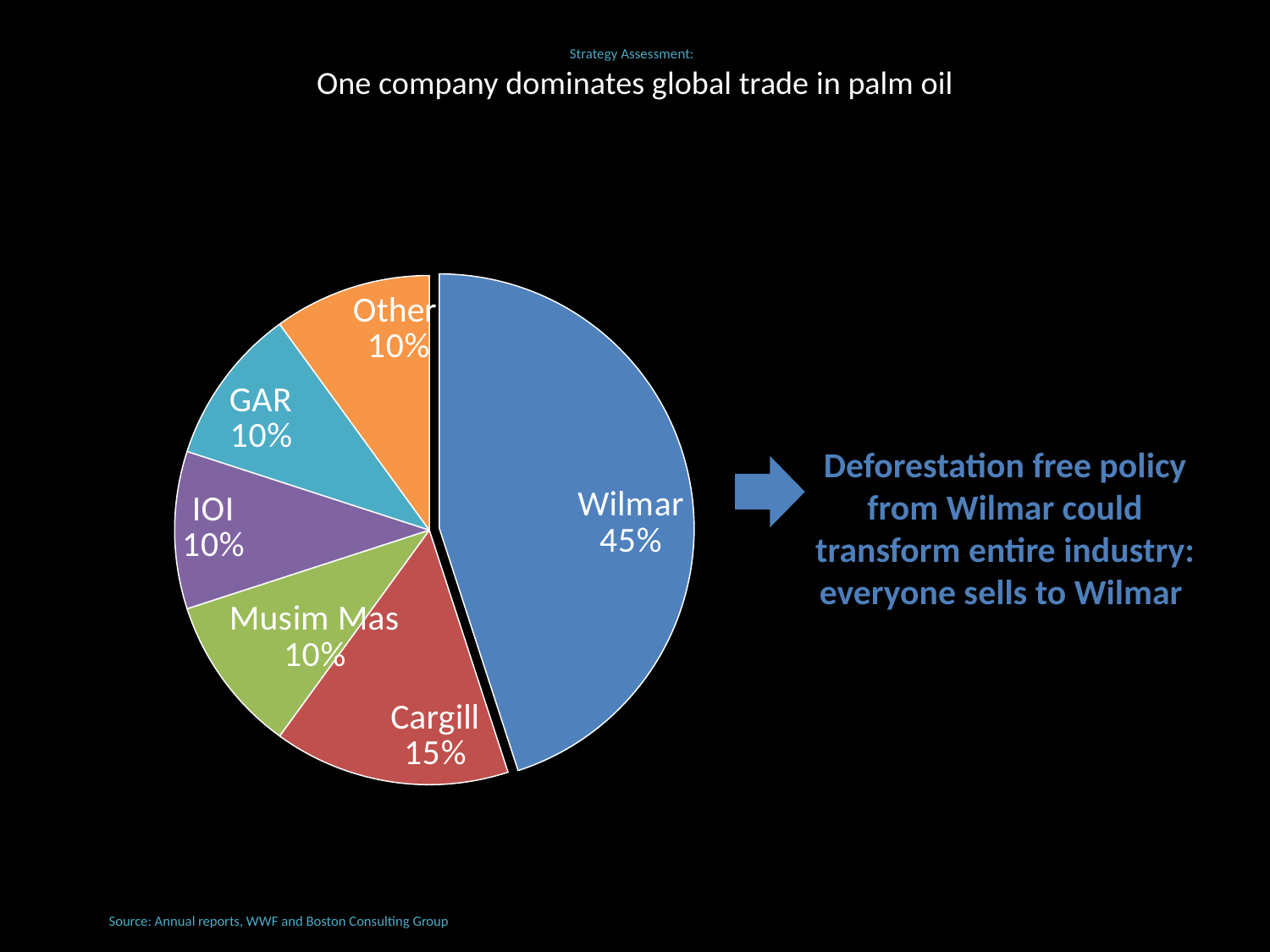
What is the value shown for IOI? 10% What is the value shown for Cargill? 15% What share of the pie does Wilmar hold? 45% How many slices does the pie chart have? 6 Which is larger, the slice for Cargill or the slice for GAR? Cargill What is the combined share of Cargill and Other? 25% What colour is the slice for Other? Orange Which slice of the pie is pulled out from the rest? Wilmar What is the difference between Wilmar's share and Cargill's share? 30% What kind of chart is shown on the slide? Pie chart Which company has the largest slice of the pie? Wilmar What is the value shown for Musim Mas? 10%